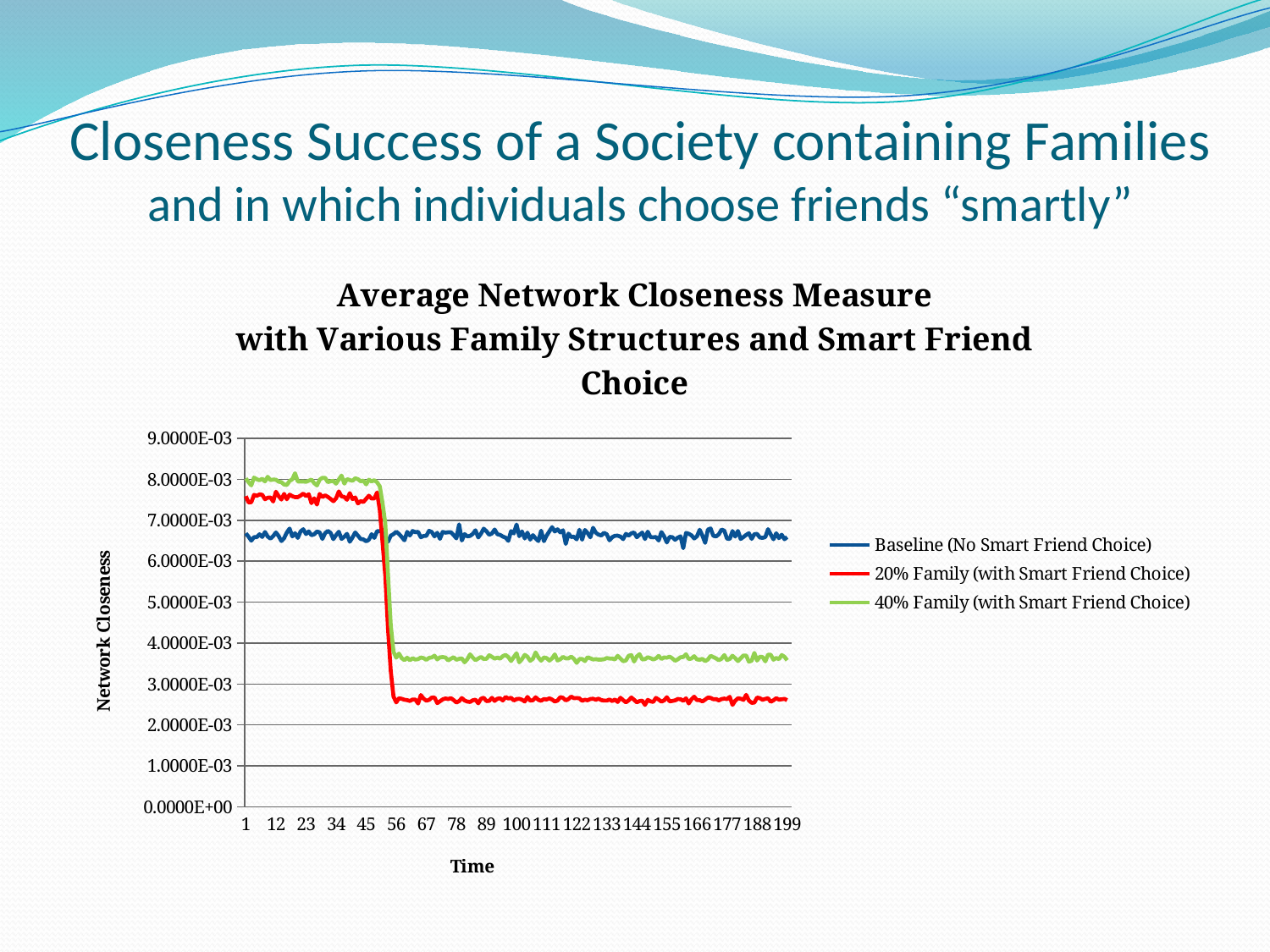
Is the value of the 20% Family (with Smart Friend Choice) series at time 23 greater or less than 7.0000E-03? greater What is the label of the vertical axis? Network Closeness Which series has the lowest value at time 199? 20% Family (with Smart Friend Choice) How many series does the legend list? 3 Does the 20% Family (with Smart Friend Choice) series rise or fall sharply around time 50? fall At time 100, which series has the higher value: Baseline (No Smart Friend Choice) or 20% Family (with Smart Friend Choice)? Baseline (No Smart Friend Choice) Is the value of the Baseline (No Smart Friend Choice) series at time 100 greater or less than 6.0000E-03? greater What kind of chart is shown on the slide? line chart Is the value of the 40% Family (with Smart Friend Choice) series at time 150 greater or less than 4.0000E-03? less What is the title of the chart? Average Network Closeness Measure with Various Family Structures and Smart Friend Choice At time 12, which series has the higher value: 40% Family (with Smart Friend Choice) or Baseline (No Smart Friend Choice)? 40% Family (with Smart Friend Choice)